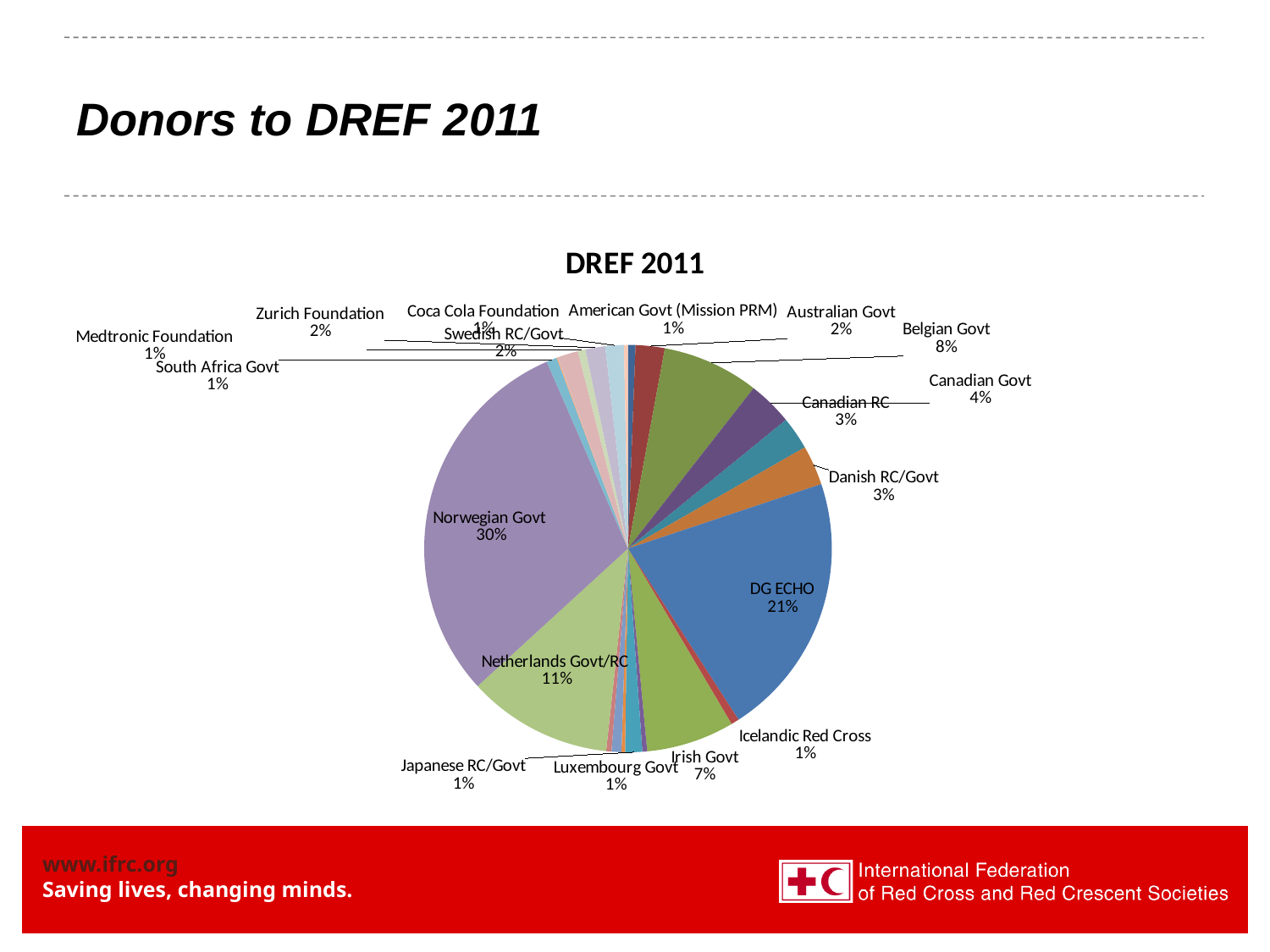
What percentage is shown for the Australian Govt? 2% What type of chart is shown on the slide? pie chart What share of the pie is attributed to DG ECHO? 21% What is the title of the chart? DREF 2011 What is the difference in percentage points between the Norwegian Govt and DG ECHO shares? 9 What percentage is shown for the Belgian Govt? 8% Which donor has the largest share of the pie? Norwegian Govt What share of DREF 2011 donations came from the Norwegian Govt? 30% What percentage is shown for the Danish RC/Govt? 3% Which is larger, the share for the Irish Govt or the share for the Canadian Govt? Irish Govt What percentage is shown for Netherlands Govt/RC? 11% What is the combined share of the Norwegian Govt and Netherlands Govt/RC? 41%